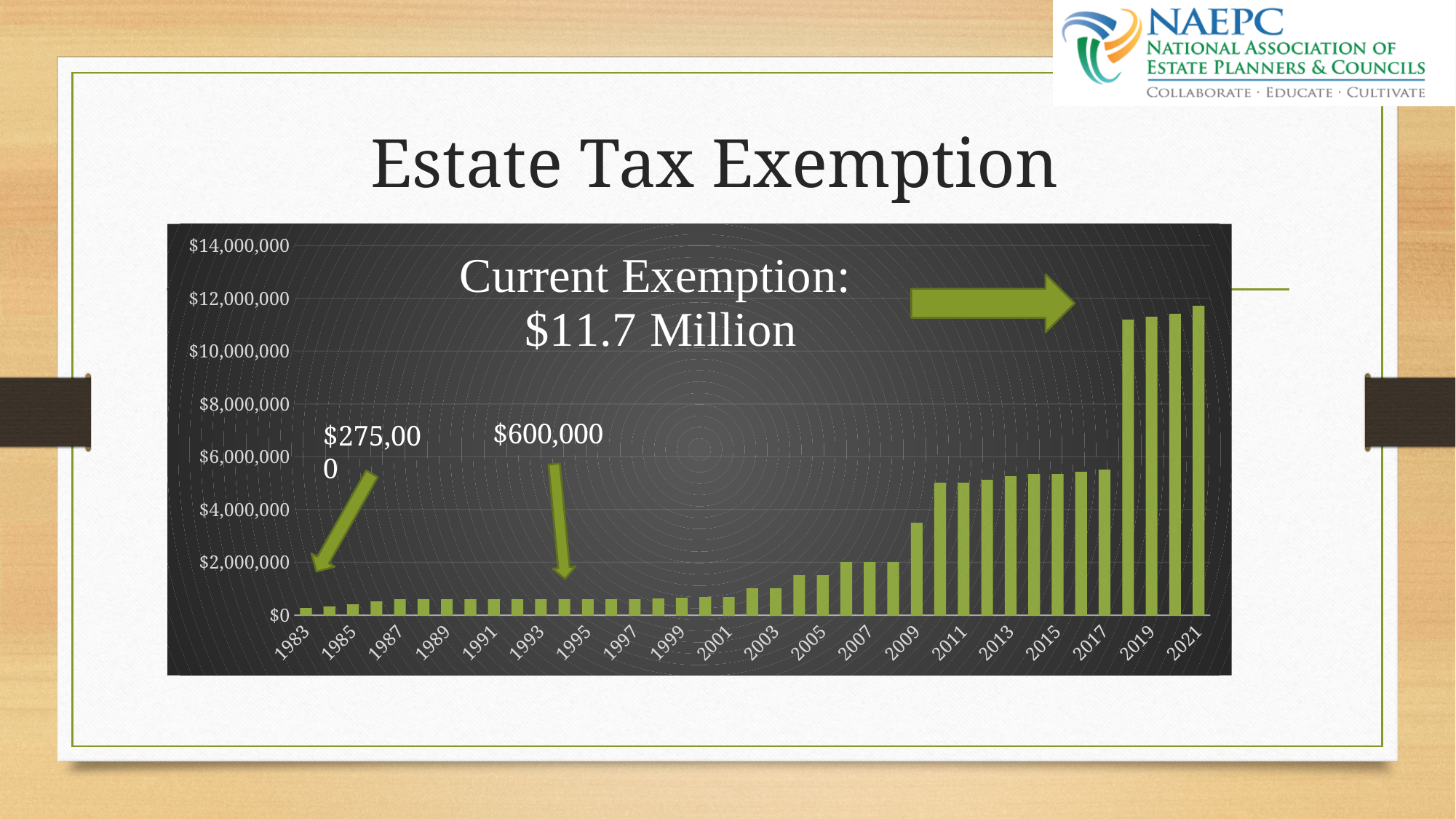
What is the title of the slide's chart? Estate Tax Exemption Is the value for 2019 greater or less than $10,000,000? greater What is the current estate tax exemption shown for 2021? $11.7 Million Do the estate tax exemption values generally rise or fall from 1983 to 2021? rise What kind of chart is shown on the slide? bar chart Is the value for 2001 greater or less than $2,000,000? less Is the value for 2009 greater or less than $4,000,000? less Which year has the lowest estate tax exemption? 1983 Which is larger, the value for 2017 or the value for 2019? 2019 What is the highest value labelled on the vertical axis? $14,000,000 Which year has the highest estate tax exemption? 2021 What is the estate tax exemption value annotated for 1983? $275,000